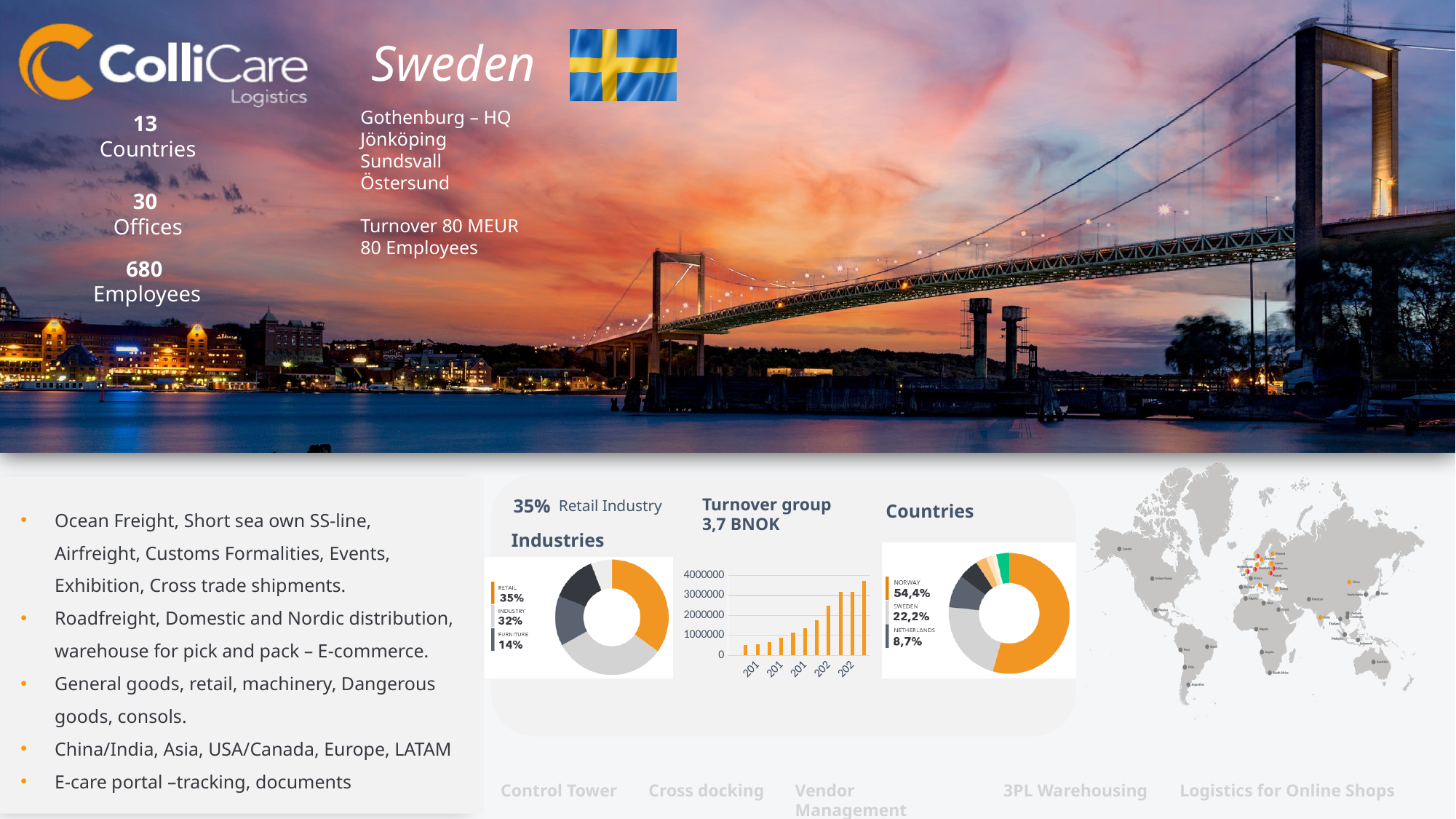
On the Countries chart, which of the labelled countries has the smallest share? Netherlands On the Countries chart, what share is shown for Netherlands? 8,7% On the Industries chart, what share is shown for Furniture? 14% On the Industries chart, which of the labelled industries has the largest share? Retail What kind of chart is the Turnover group chart? Bar chart On the Countries chart, what share is shown for Norway? 54,4% On the Industries chart, what is the difference between the Retail and Industry shares? 3% On the Industries chart, what share is shown for Industry? 32% On the Turnover group chart, do the values generally rise or fall from left to right? Rise On the Countries chart, which is larger, the share for Sweden or the share for Netherlands? Sweden On the Industries chart, what share is shown for Retail? 35% On the Countries chart, what share is shown for Sweden? 22,2%